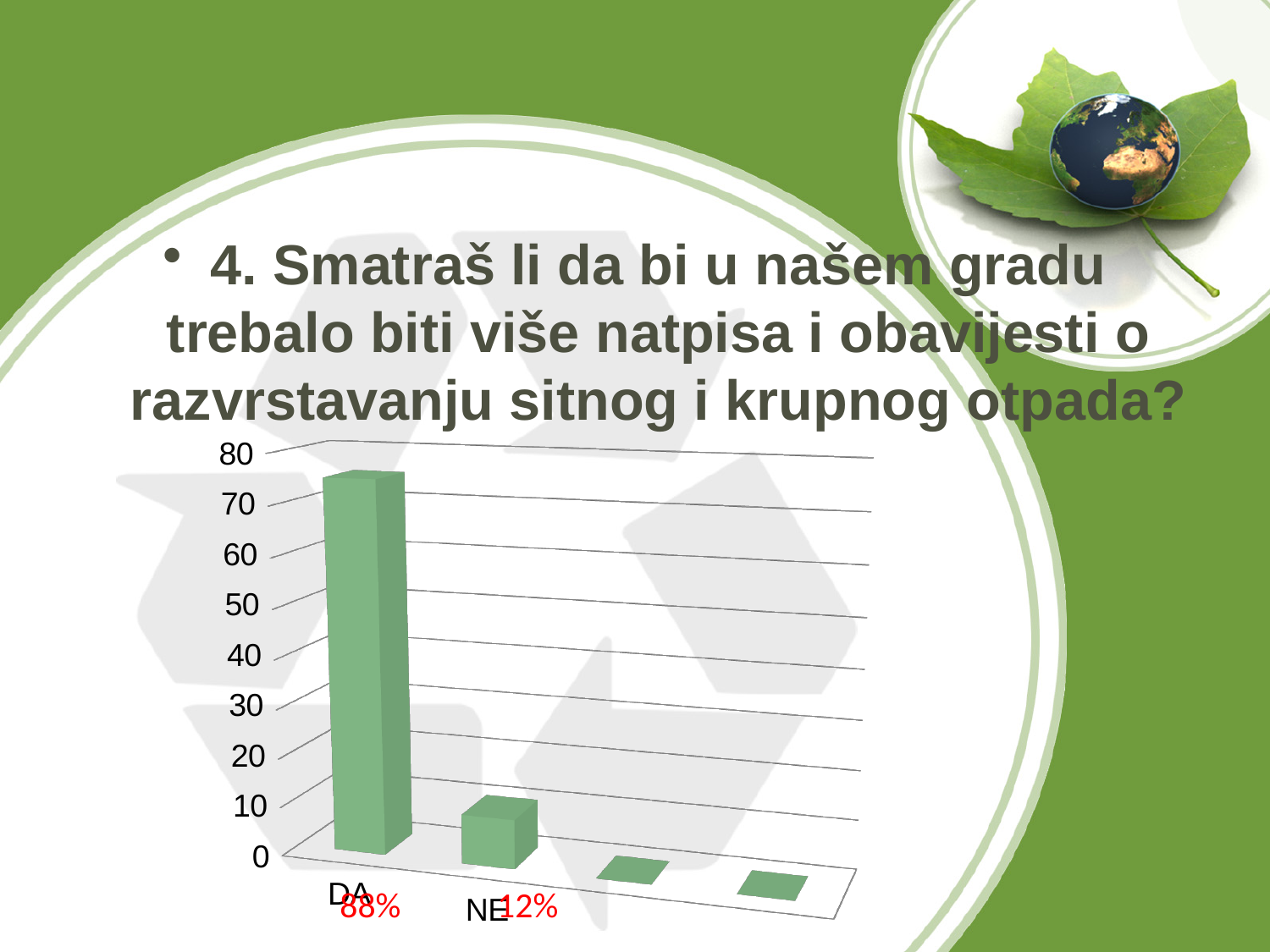
Is the value for DA greater or less than 70? greater Which category has the highest bar, DA or NE? DA What kind of chart is shown on the slide? bar chart Which of the two labelled categories, DA or NE, has the lowest bar? NE Is the value for DA greater or less than 80? less Is the bar for DA taller than the bar for NE? Yes Is the value for NE greater or less than 50? less What is the highest value shown on the vertical axis? 80 What are the two category labels shown on the horizontal axis? DA and NE